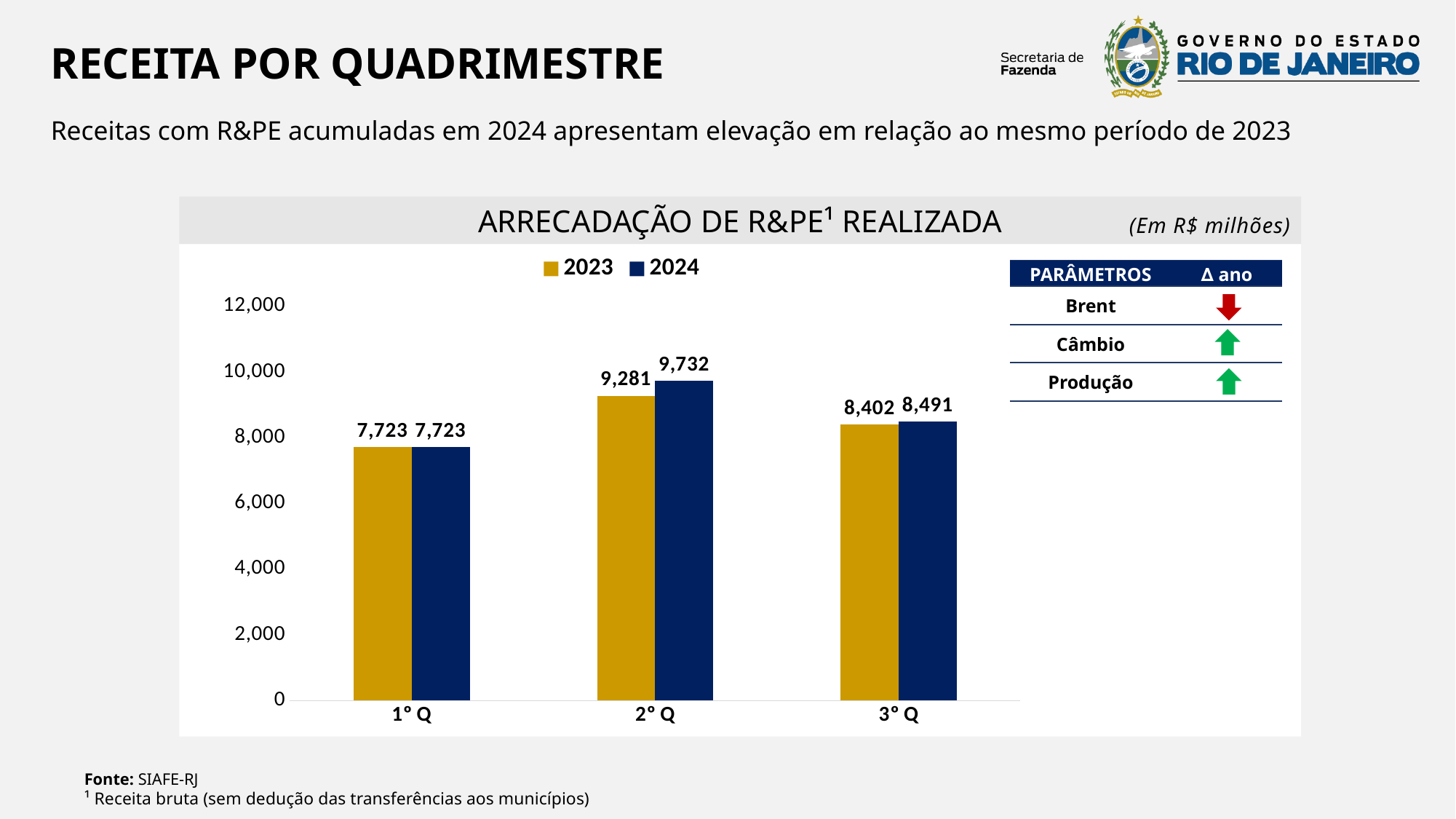
What kind of chart is shown? bar chart What is the 2023 value for 2° Q? 9,281 What is the difference between the 2024 and 2023 values for 2° Q? 451 What is the difference between the 2024 and 2023 values for 3° Q? 89 Which quadrimester has the highest 2024 value? 2° Q What is the 2024 value for 3° Q? 8,491 Is the 2023 value for 3° Q greater or less than 8,000? greater What is the 2024 value for 1° Q? 7,723 Which is larger for 2° Q, the 2023 value or the 2024 value? 2024 Which quadrimester has the lowest 2023 value? 1° Q How many quadrimesters are shown on the x axis? 3 How many series does the legend list? 2